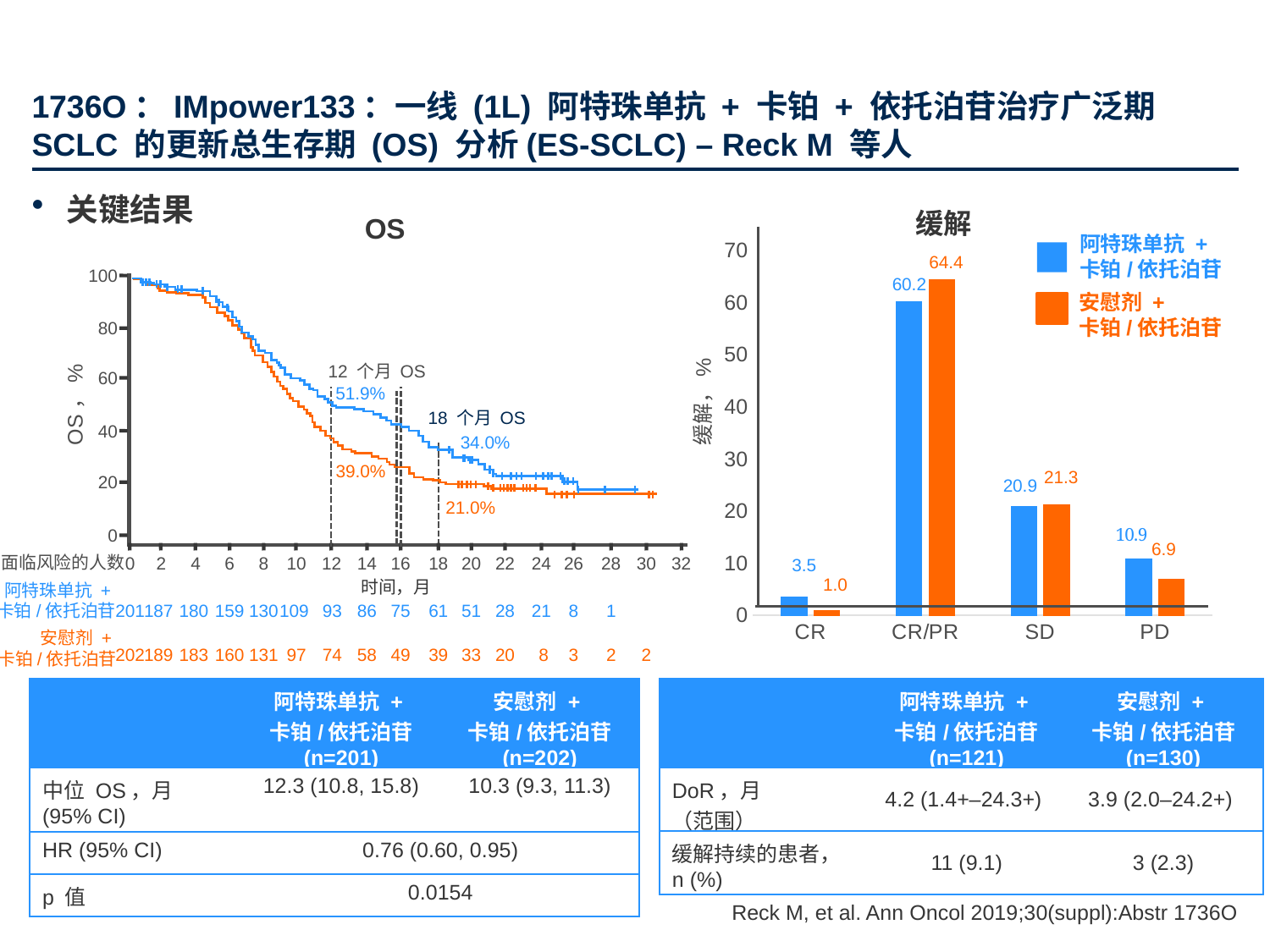
How many categories are shown on the x axis of the 缓解 chart? 4 In the 缓解 chart, what is the difference between the CR/PR values of 安慰剂 + 卡铂/依托泊苷 and 阿特珠单抗 + 卡铂/依托泊苷? 4.2 In the 缓解 chart, which series has the larger PD value? 阿特珠单抗 + 卡铂/依托泊苷 In the 缓解 chart, which category has the highest value for 阿特珠单抗 + 卡铂/依托泊苷? CR/PR In the OS chart, what is the 12-month OS for 阿特珠单抗 + 卡铂/依托泊苷? 51.9% What kind of chart is the 缓解 chart? bar chart In the 缓解 chart, what is the CR/PR value for 阿特珠单抗 + 卡铂/依托泊苷? 60.2 In the OS chart, do the survival curves rise or fall as time increases along the x axis? fall How many series does the legend of the 缓解 chart list? 2 In the OS chart, what is the 18-month OS for 安慰剂 + 卡铂/依托泊苷? 21.0% In the 缓解 chart, which category has the lowest value for 安慰剂 + 卡铂/依托泊苷? CR In the 缓解 chart, what is the PD value for 安慰剂 + 卡铂/依托泊苷? 6.9